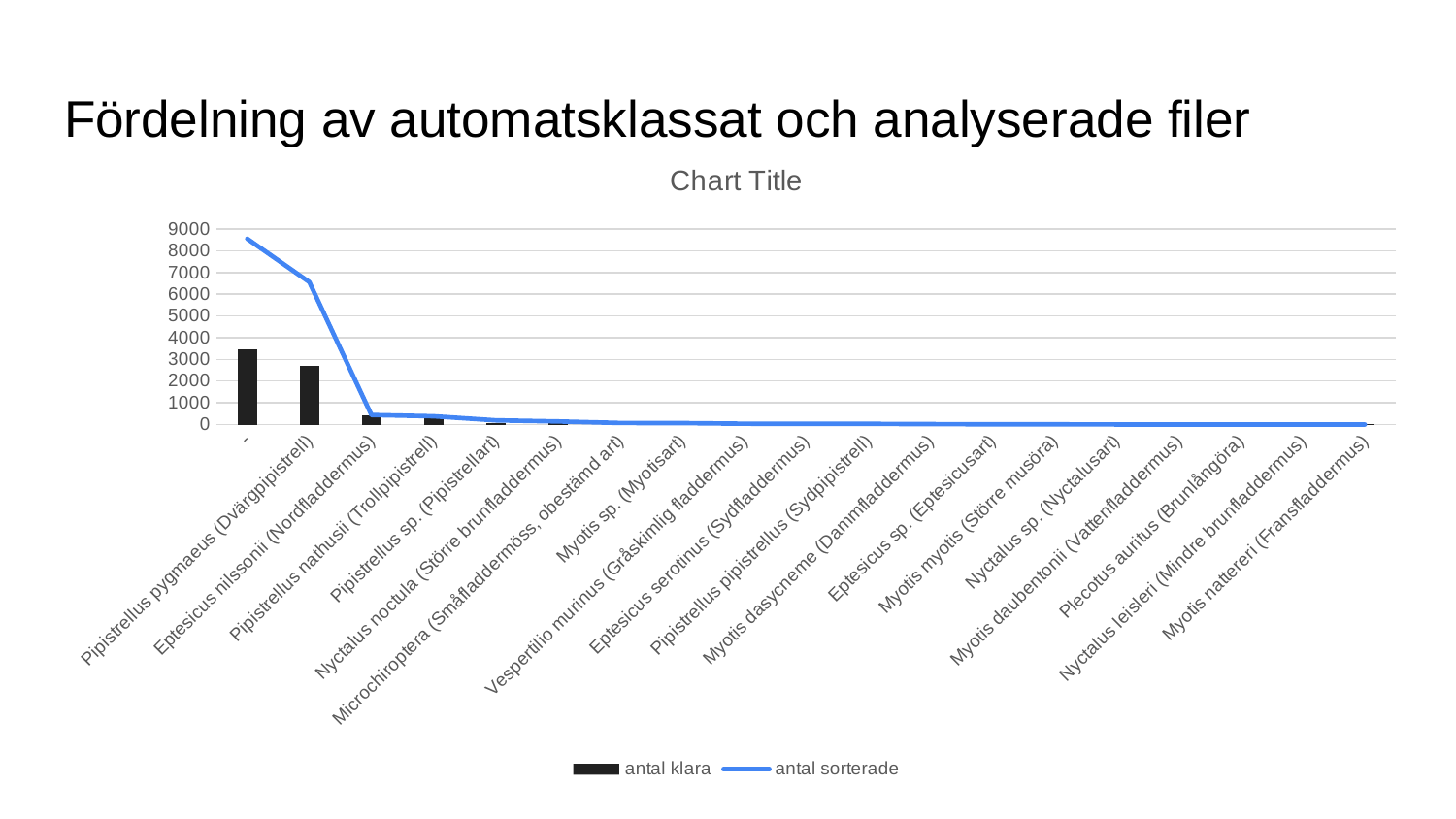
Which has the larger antal klara value: Pipistrellus pygmaeus (Dvärgpipistrell) or Eptesicus nilssonii (Nordfladdermus)? Pipistrellus pygmaeus (Dvärgpipistrell) Is the antal sorterade value for Eptesicus nilssonii (Nordfladdermus) greater or less than 1000? less Is the antal sorterade value for Pipistrellus pygmaeus (Dvärgpipistrell) greater or less than 6000? greater Does the antal sorterade line rise or fall from left to right along the x axis? Fall Is the antal klara value for Pipistrellus pygmaeus (Dvärgpipistrell) greater or less than 3000? less Which series is drawn as a line? antal sorterade For Pipistrellus pygmaeus (Dvärgpipistrell), which is larger: antal klara or antal sorterade? antal sorterade What are the two series named in the legend? antal klara and antal sorterade What kind of chart is shown? A combined bar and line chart How many series does the legend list? 2